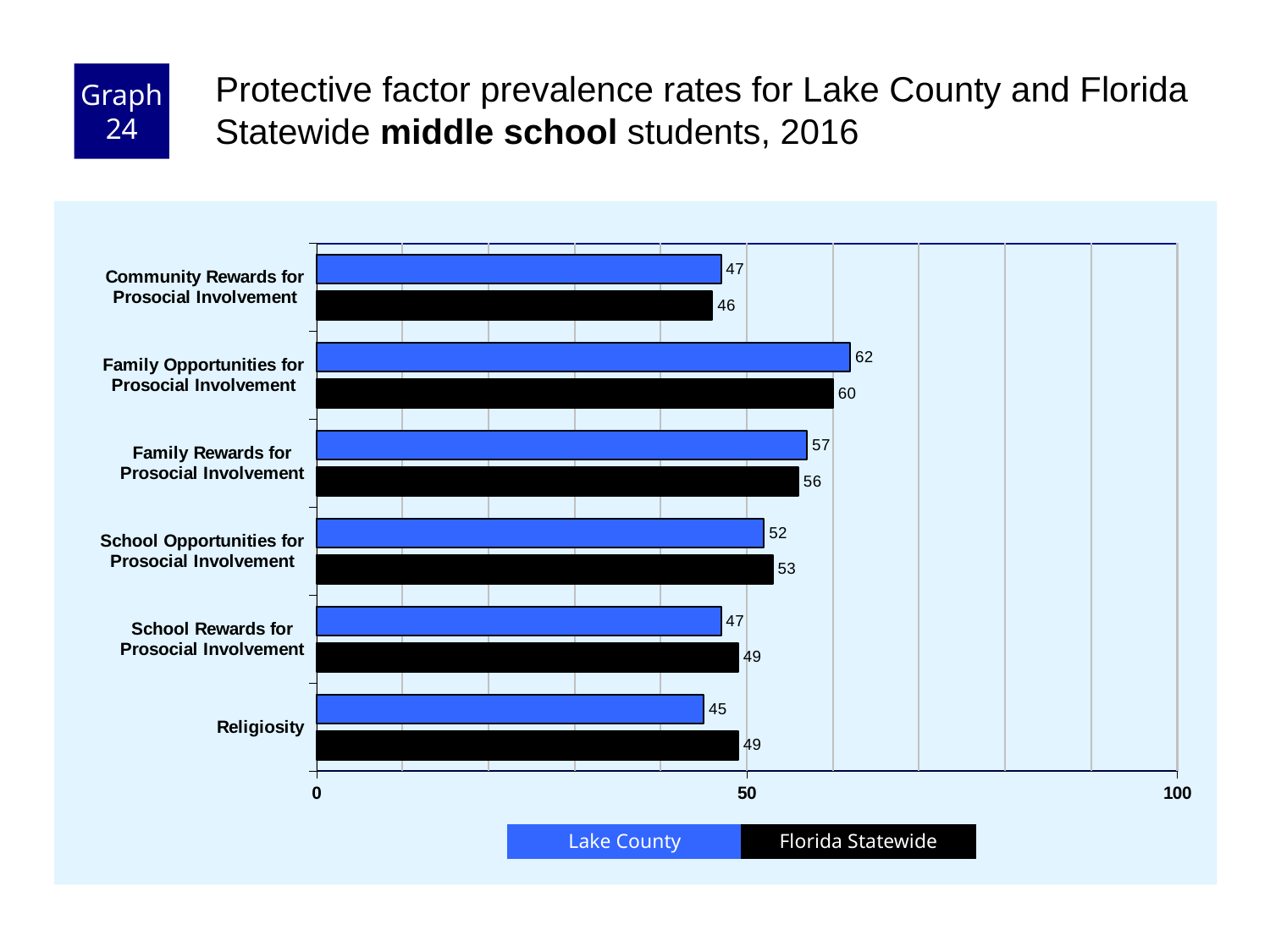
How many series does the legend list? 2 What kind of chart is shown on the slide? Bar chart Is the Lake County value for Family Rewards for Prosocial Involvement greater or less than 50? greater How many categories are shown on the chart? 6 What is the Florida Statewide value for Religiosity? 49 Which category has the highest Lake County value? Family Opportunities for Prosocial Involvement What is the difference between the Lake County and Florida Statewide values for Religiosity? 4 Which category has the lowest Lake County value? Religiosity What is the Lake County value for Family Opportunities for Prosocial Involvement? 62 What is the Florida Statewide value for School Opportunities for Prosocial Involvement? 53 Which colour represents Florida Statewide in the chart? Black For School Rewards for Prosocial Involvement, which is larger: the Lake County value or the Florida Statewide value? Florida Statewide